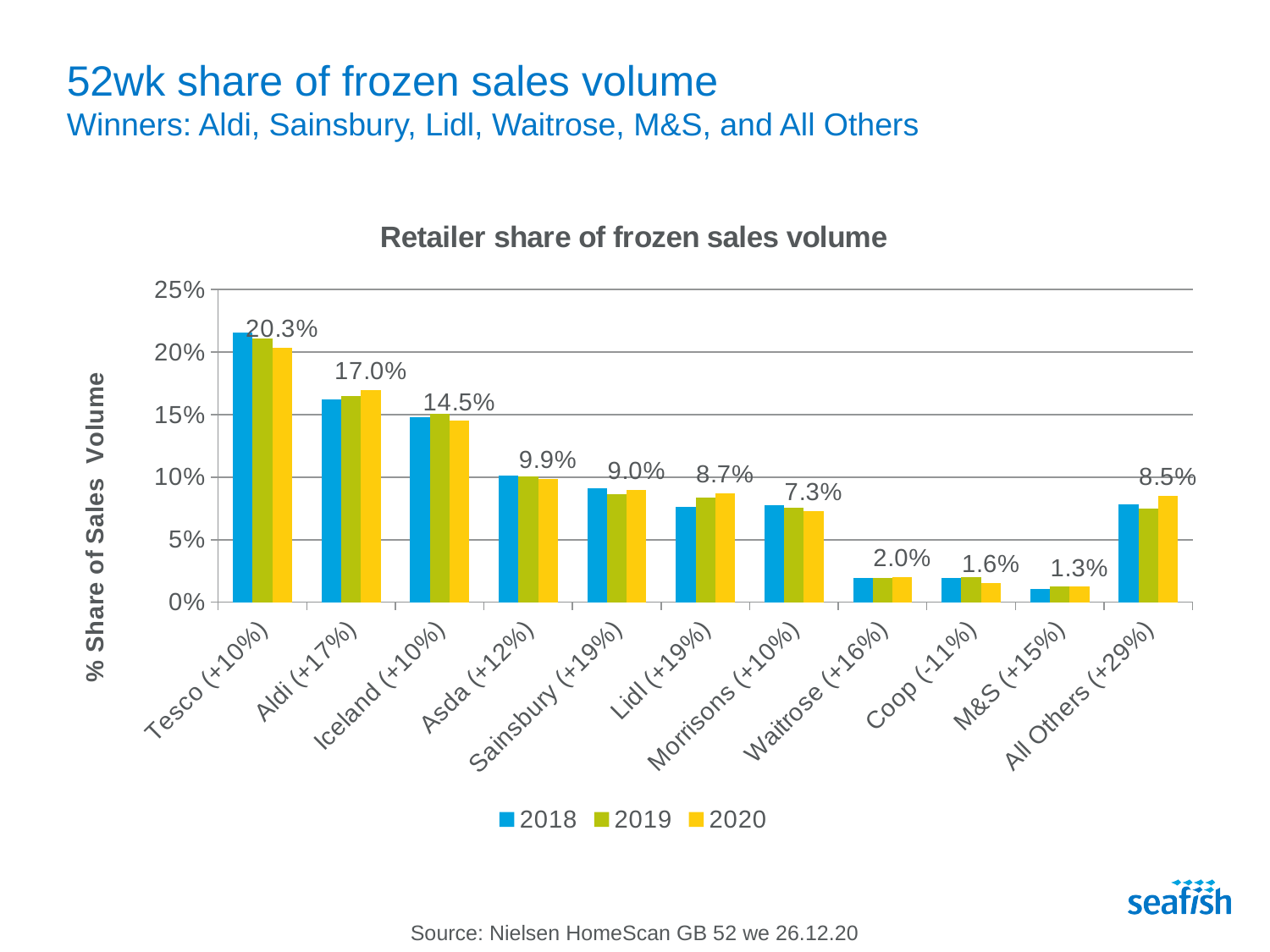
What is the 2020 value for Waitrose? 2.0% How many retailer categories are shown on the x axis? 11 What is the 2020 value for All Others? 8.5% How many series does the legend list? 3 Which retailer has the highest 2020 share of frozen sales volume? Tesco What is the difference between the 2020 values for Tesco and Aldi? 3.3% What is the 2020 value for Aldi? 17.0% Which is larger in 2020, the share for Asda or the share for Sainsbury? Asda Is the 2018 value for Tesco greater or less than 20%? greater What is the 2020 value for Tesco in the Retailer share of frozen sales volume chart? 20.3% Which retailer has the lowest 2020 share of frozen sales volume? M&S What kind of chart is shown on the slide? Bar chart